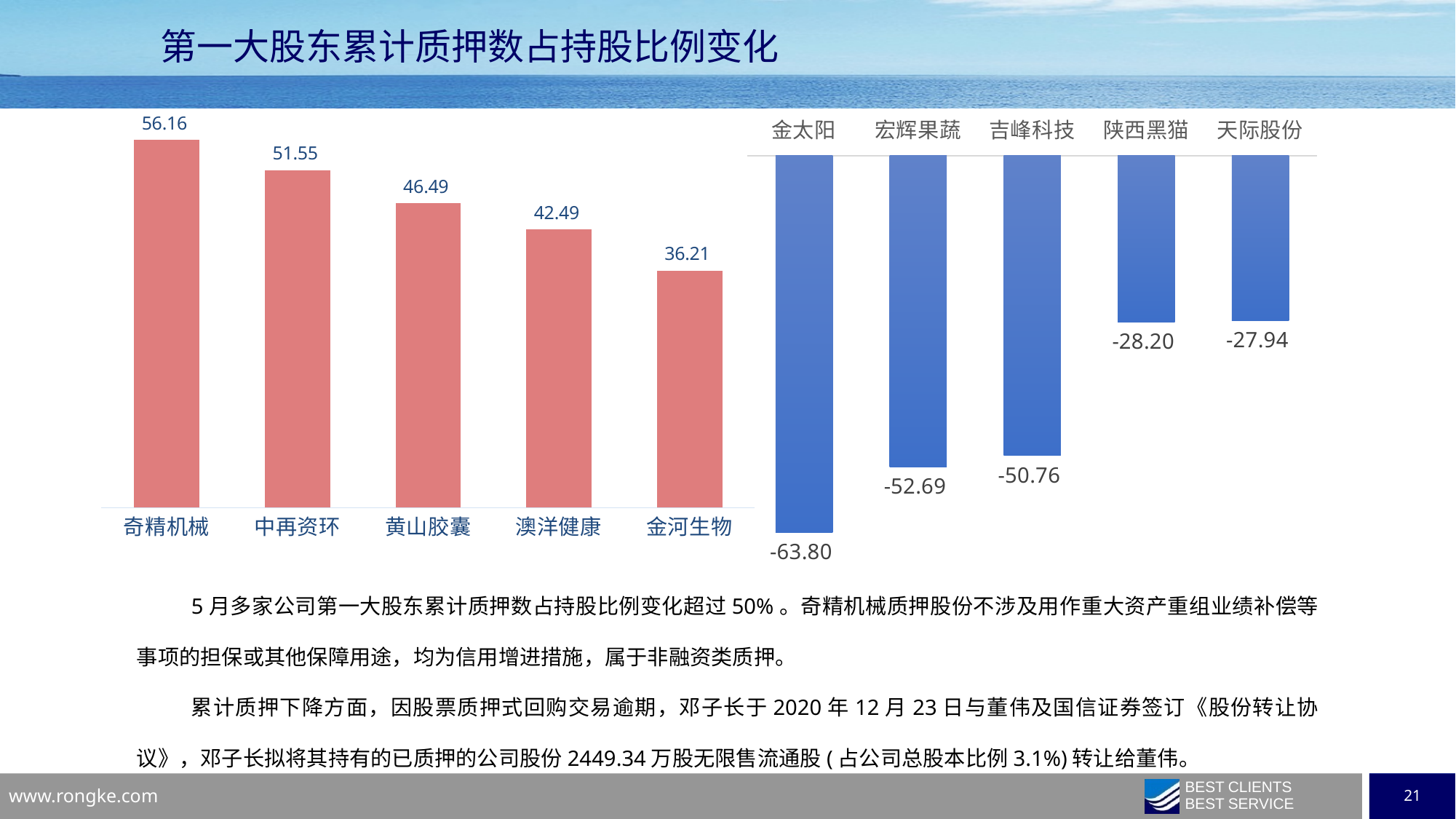
In the left chart (red bars), what is the value for 奇精机械? 56.16 In the right chart (blue bars), what is the value for 金太阳? -63.80 In the right chart (blue bars), what is the value for 陕西黑猫? -28.20 In the left chart (red bars), do the values rise or fall from left to right? Fall In the left chart (red bars), what is the value for 黄山胶囊? 46.49 In the left chart (red bars), which is larger, the value for 澳洋健康 or 金河生物? 澳洋健康 In the right chart (blue bars), which company has the largest decline (most negative value)? 金太阳 What type of chart is the right chart (blue bars)? Bar chart In the left chart (red bars), which company has the lowest value? 金河生物 How many companies are shown in the left chart (red bars)? 5 In the right chart (blue bars), what is the difference between the values for 宏辉果蔬 and 吉峰科技? 1.93 In the left chart (red bars), what is the difference between the values for 奇精机械 and 中再资环? 4.61